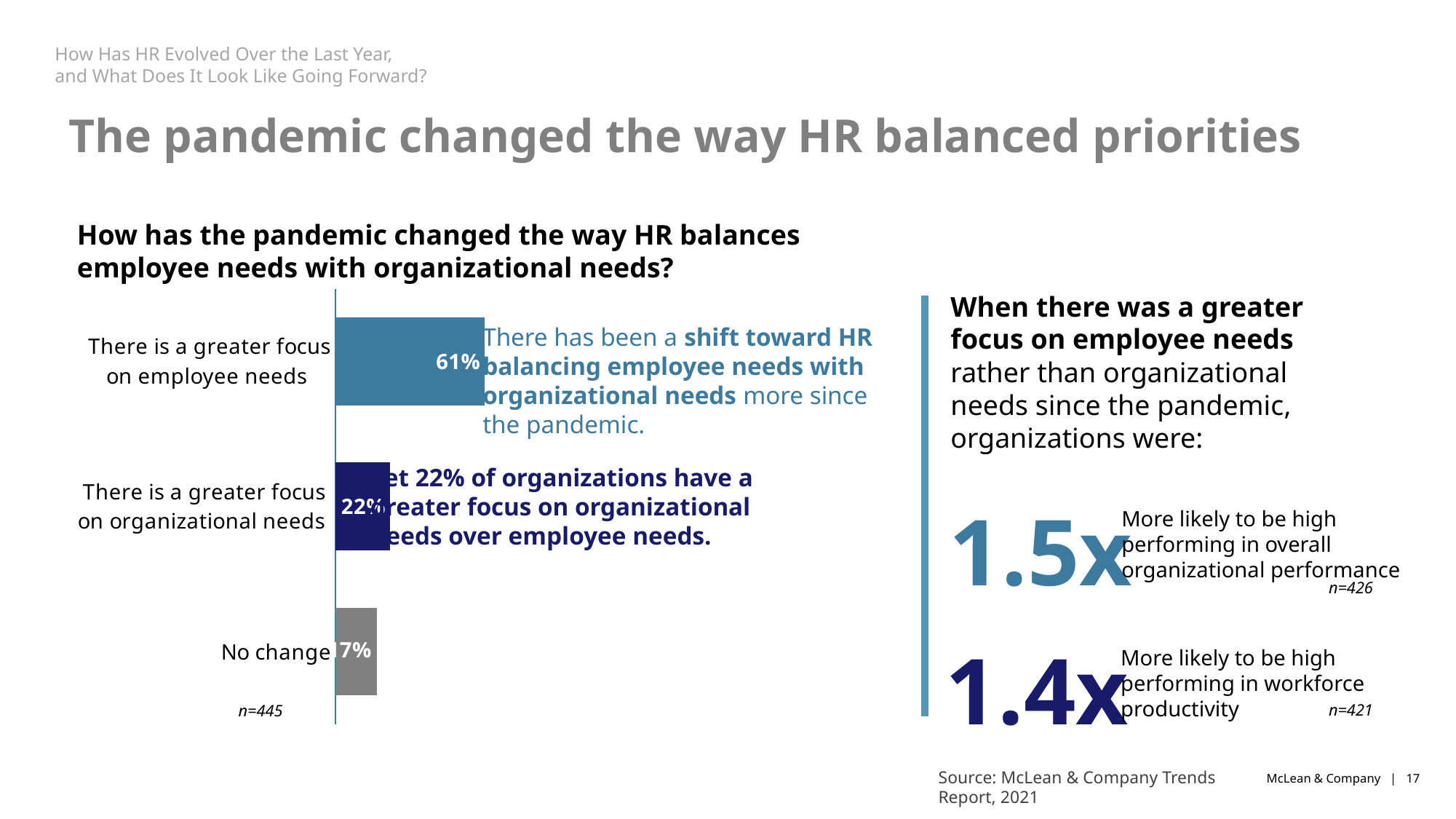
How many categories are shown in the bar chart? 3 What is the sample size (n) shown for the bar chart? n=445 What percentage of respondents reported no change? 17% What percentage of respondents said there is a greater focus on organizational needs? 22% What type of chart is shown on the slide? Bar chart Which is larger: the value for greater focus on organizational needs or the value for no change? There is a greater focus on organizational needs What is the difference in percentage points between the greater focus on employee needs and the greater focus on organizational needs? 39 What is the difference in percentage points between the greater focus on organizational needs and no change? 5 What is the question the bar chart answers, as shown in its title? How has the pandemic changed the way HR balances employee needs with organizational needs? Which category has the highest value in the chart? There is a greater focus on employee needs What percentage of respondents said there is a greater focus on employee needs? 61% Which category has the lowest value in the chart? No change